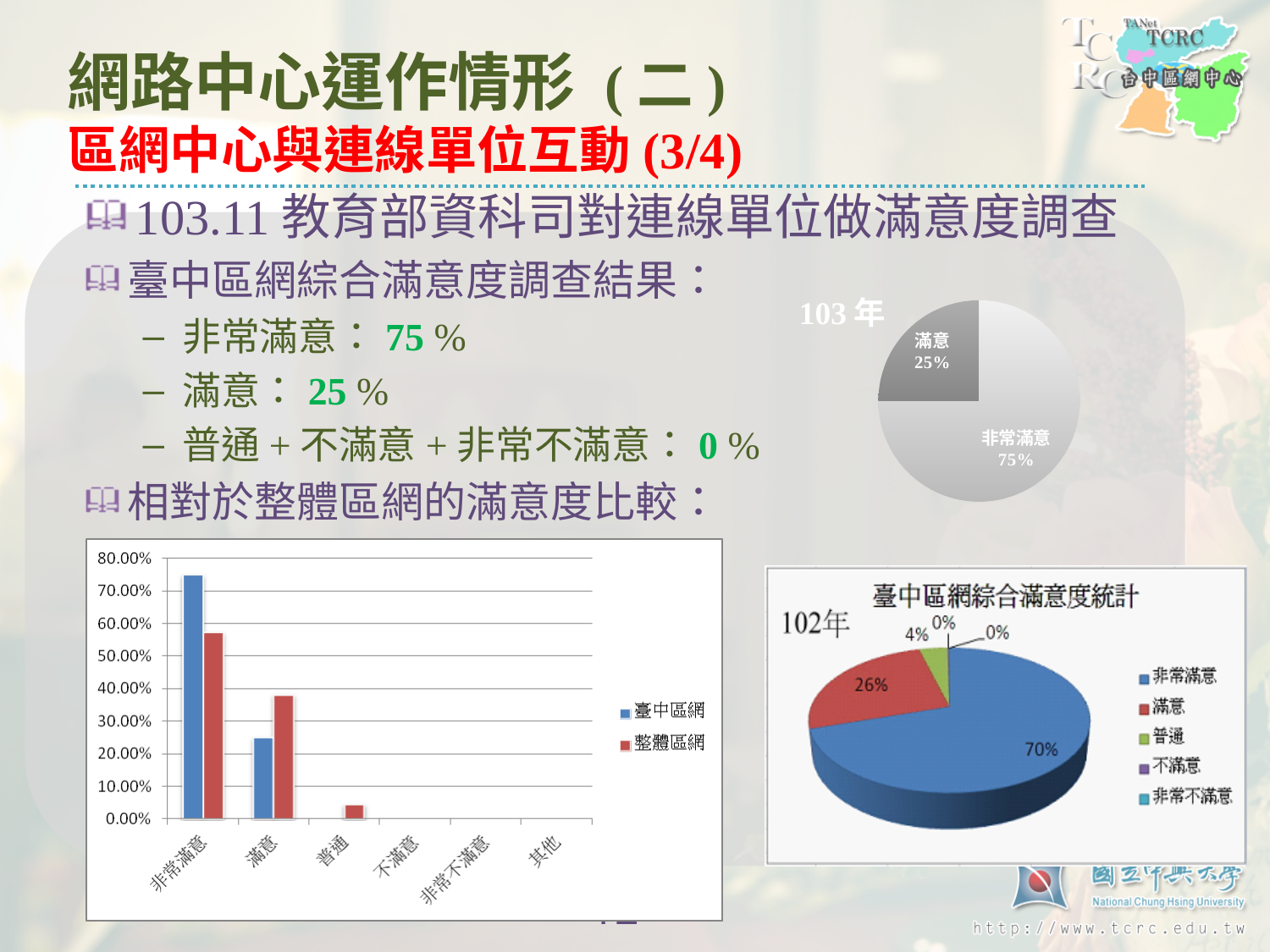
In the bar chart at the bottom left, for 滿意, which series has the larger value, 臺中區網 or 整體區網? 整體區網 In the bar chart at the bottom left, is the 臺中區網 value for 非常滿意 greater or less than 70.00%? greater In the 臺中區網綜合滿意度統計 102年 pie chart, what share does the largest slice (非常滿意) have? 70% In the bar chart at the bottom left, how many categories are on the x axis? 6 In the 103年 pie chart at the top right, what share does 滿意 have? 25% In the 臺中區網綜合滿意度統計 102年 pie chart, what share does 滿意 have? 26% In the 103年 pie chart at the top right, how many slices are shown? 2 In the bar chart at the bottom left, how many series does the legend list? 2 What kind of chart is the chart at the bottom left of the slide? bar chart In the 臺中區網綜合滿意度統計 102年 pie chart, how many entries does the legend list? 5